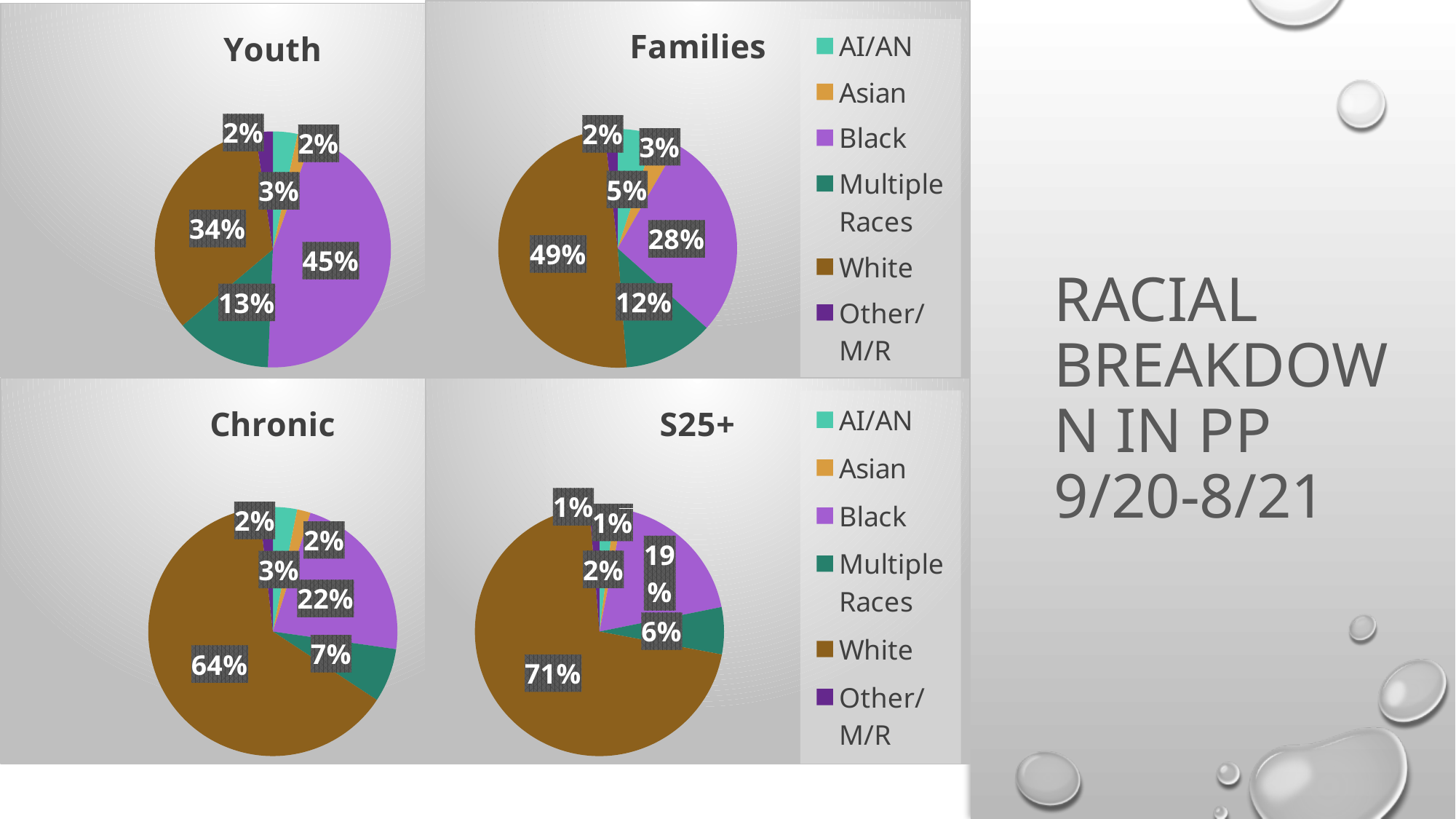
In the Youth pie chart, what percentage is White? 34% In the Families pie chart, what percentage is Multiple Races? 12% In the Youth pie chart, what percentage is Black? 45% In the Youth pie chart, which category has the largest share? Black In the Chronic pie chart, which category has the largest share? White In the Families pie chart, what is the difference between the White share and the Black share? 21% How many categories does the legend list for the Families chart? 6 In the Families pie chart, what percentage is White? 49% What kind of chart is the Chronic chart? Pie chart In the S25+ pie chart, what percentage is White? 71% Which is larger in the S25+ pie chart: the Black share or the Multiple Races share? Black In the Chronic pie chart, what percentage is Black? 22%